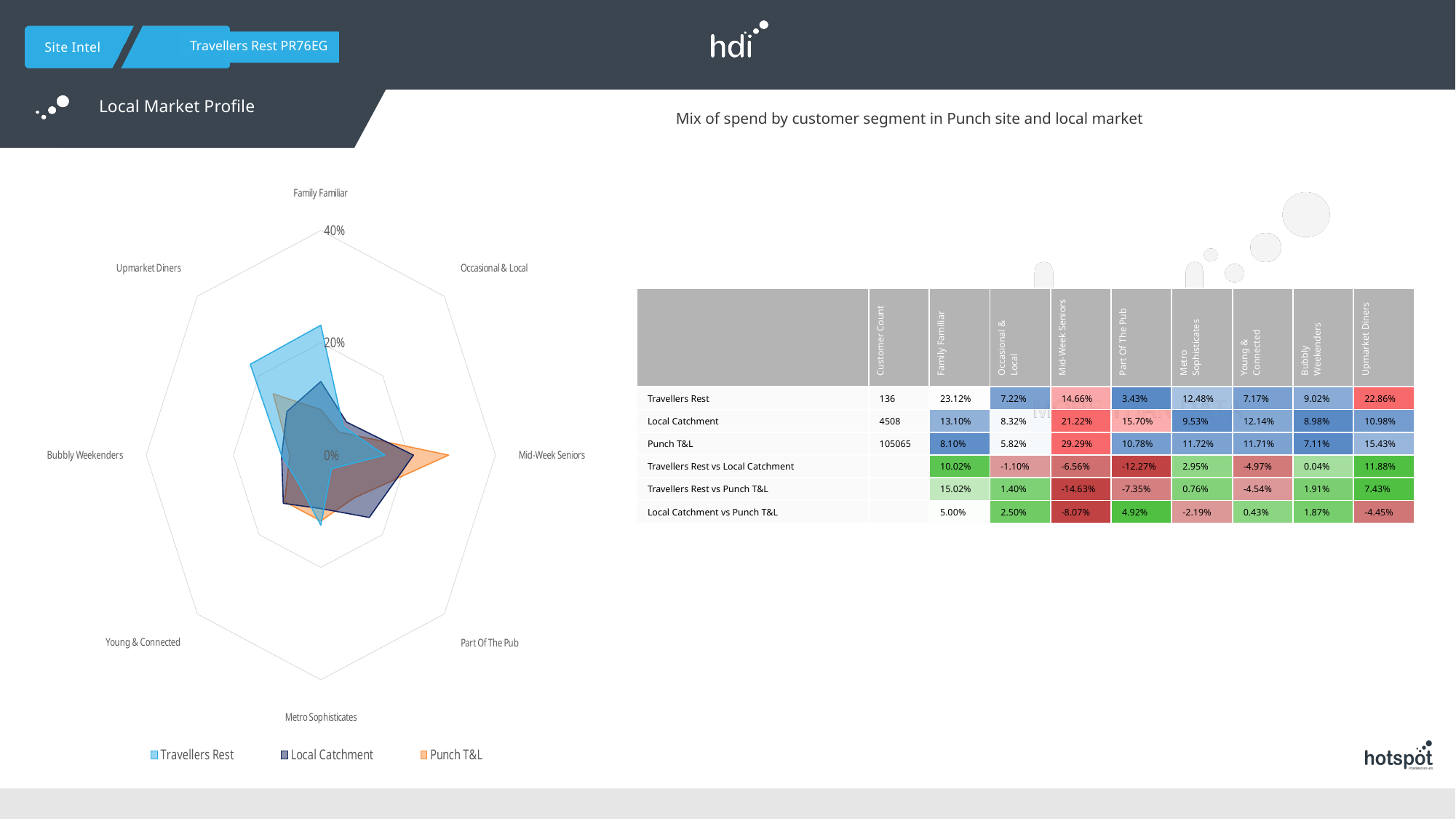
What is the difference between Travellers Rest and Local Catchment for Family Familiar? 10.02% For Mid-Week Seniors, which is larger: Travellers Rest or Local Catchment? Local Catchment What is the Customer Count for Local Catchment? 4508 What kind of chart is shown on the left of the slide? radar chart Is the Punch T&L value for Mid-Week Seniors greater or less than 20%? greater What is the Mid-Week Seniors share for Punch T&L? 29.29% How many customer segments are plotted around the radar chart? 8 Which segment has the highest share for Punch T&L? Mid-Week Seniors What is the Family Familiar share for Travellers Rest? 23.12% Which segment has the lowest share for Travellers Rest? Part Of The Pub What colour represents Punch T&L in the radar chart legend? orange How many series does the radar chart's legend list? 3